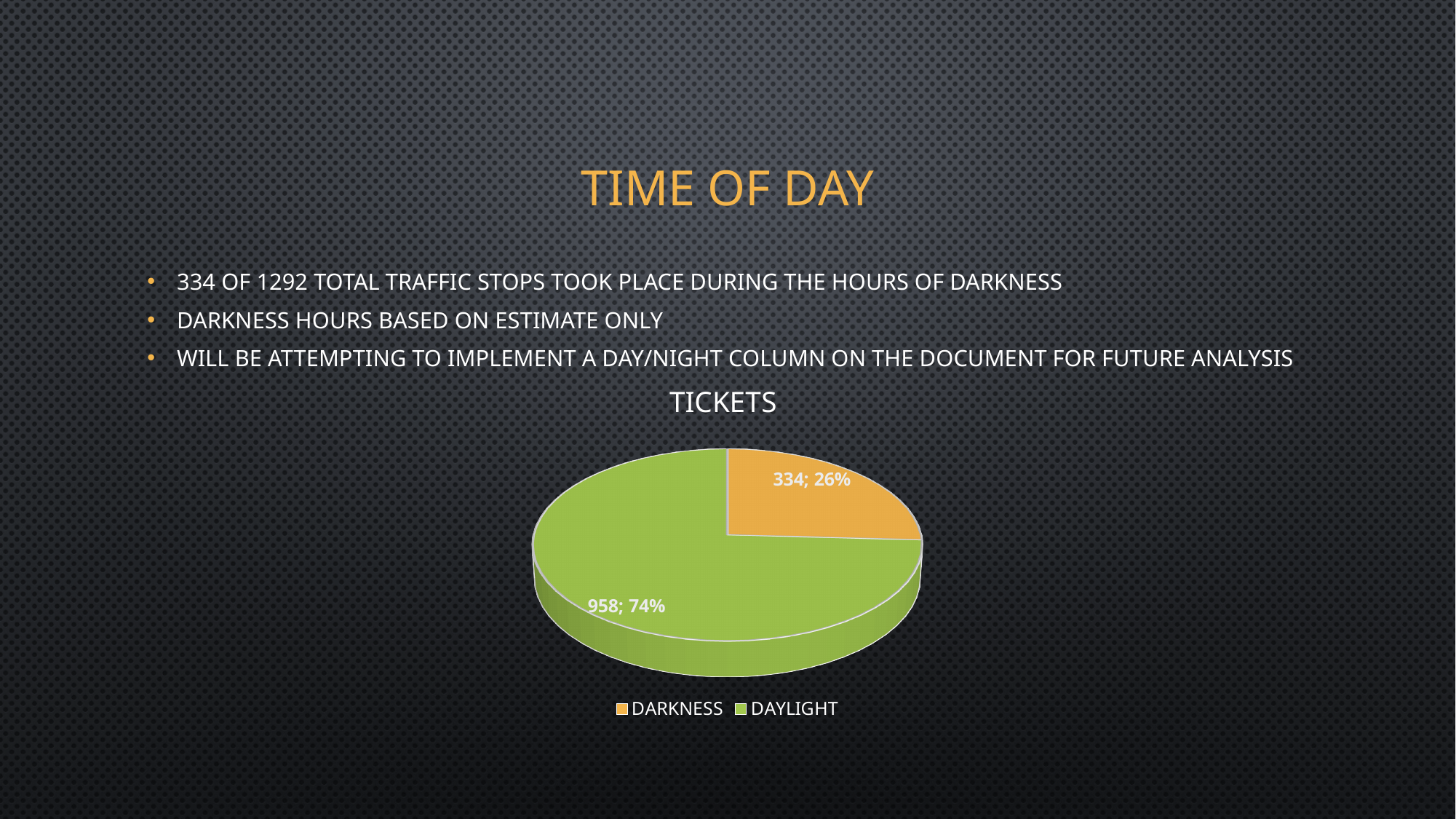
What is the total number of tickets across both slices? 1292 Which category has the smallest slice of the pie? DARKNESS How many tickets are shown for DAYLIGHT? 958 How many categories does the pie chart have? 2 What type of chart is shown on the slide? Pie chart Which is larger, the DARKNESS slice or the DAYLIGHT slice? DAYLIGHT How many tickets are shown for DARKNESS? 334 What percentage share of the pie does DAYLIGHT represent? 74% What is the difference in tickets between DAYLIGHT and DARKNESS? 624 What is the title of the chart? TICKETS Which category has the largest slice of the pie? DAYLIGHT What percentage share of the pie does DARKNESS represent? 26%